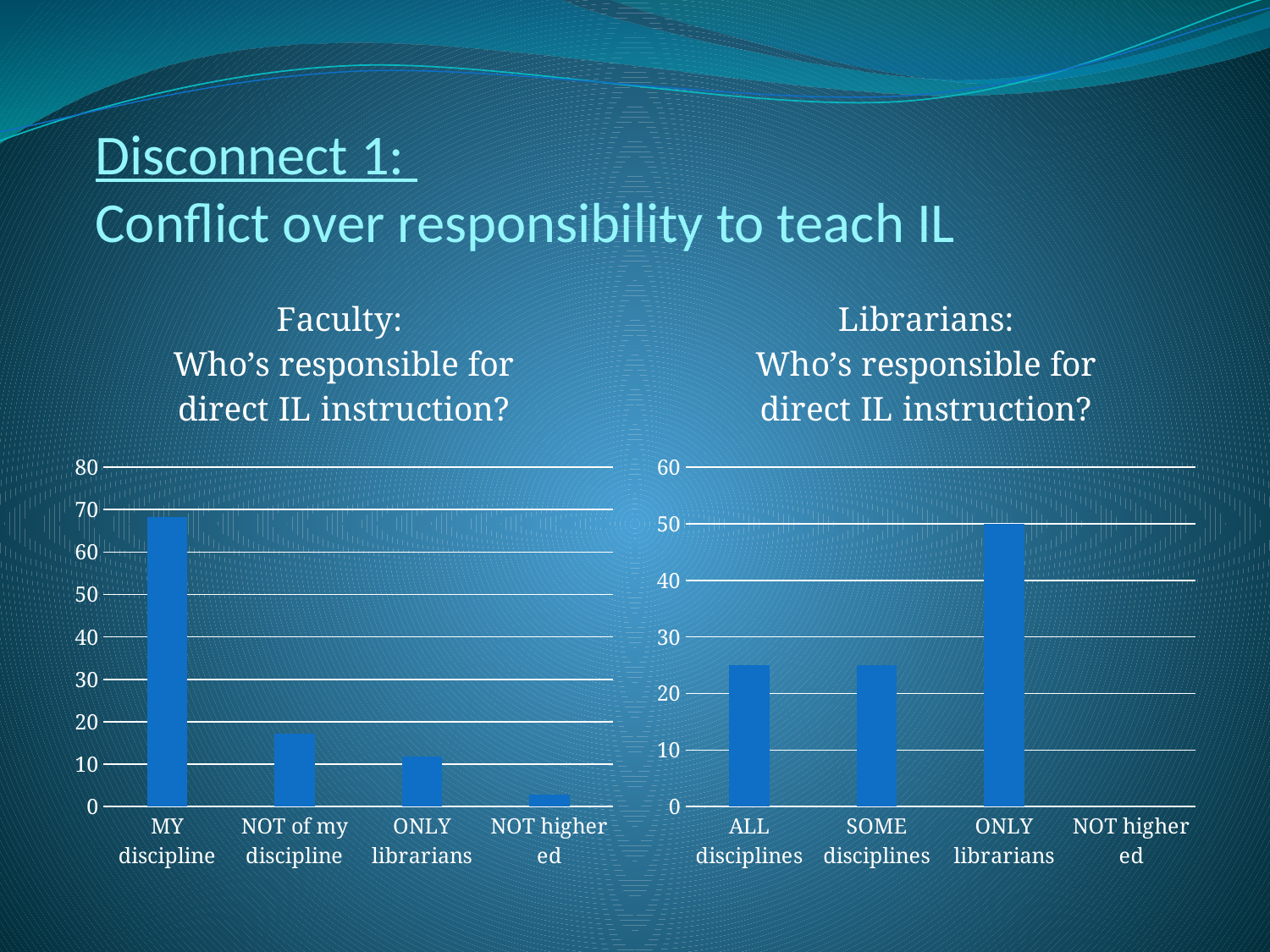
On the Faculty chart on the left, which category has the lowest value? NOT higher ed On the Faculty chart on the left, is the value for NOT of my discipline greater or less than 20? less On the Faculty chart on the left, which is larger: NOT of my discipline or ONLY librarians? NOT of my discipline What is the title of the chart on the right? Librarians: Who's responsible for direct IL instruction? On the Faculty chart on the left, which category has the highest value? MY discipline How many categories are shown on the Faculty chart on the left? 4 What kind of chart is the Faculty chart on the left? bar chart On the Librarians chart on the right, which category has the lowest value? NOT higher ed On the Librarians chart on the right, what is the value for ONLY librarians? 50 On the Librarians chart on the right, is the value for ALL disciplines greater or less than 30? less On the Librarians chart on the right, which category has the highest value? ONLY librarians On the Faculty chart on the left, is the value for MY discipline greater or less than 60? greater